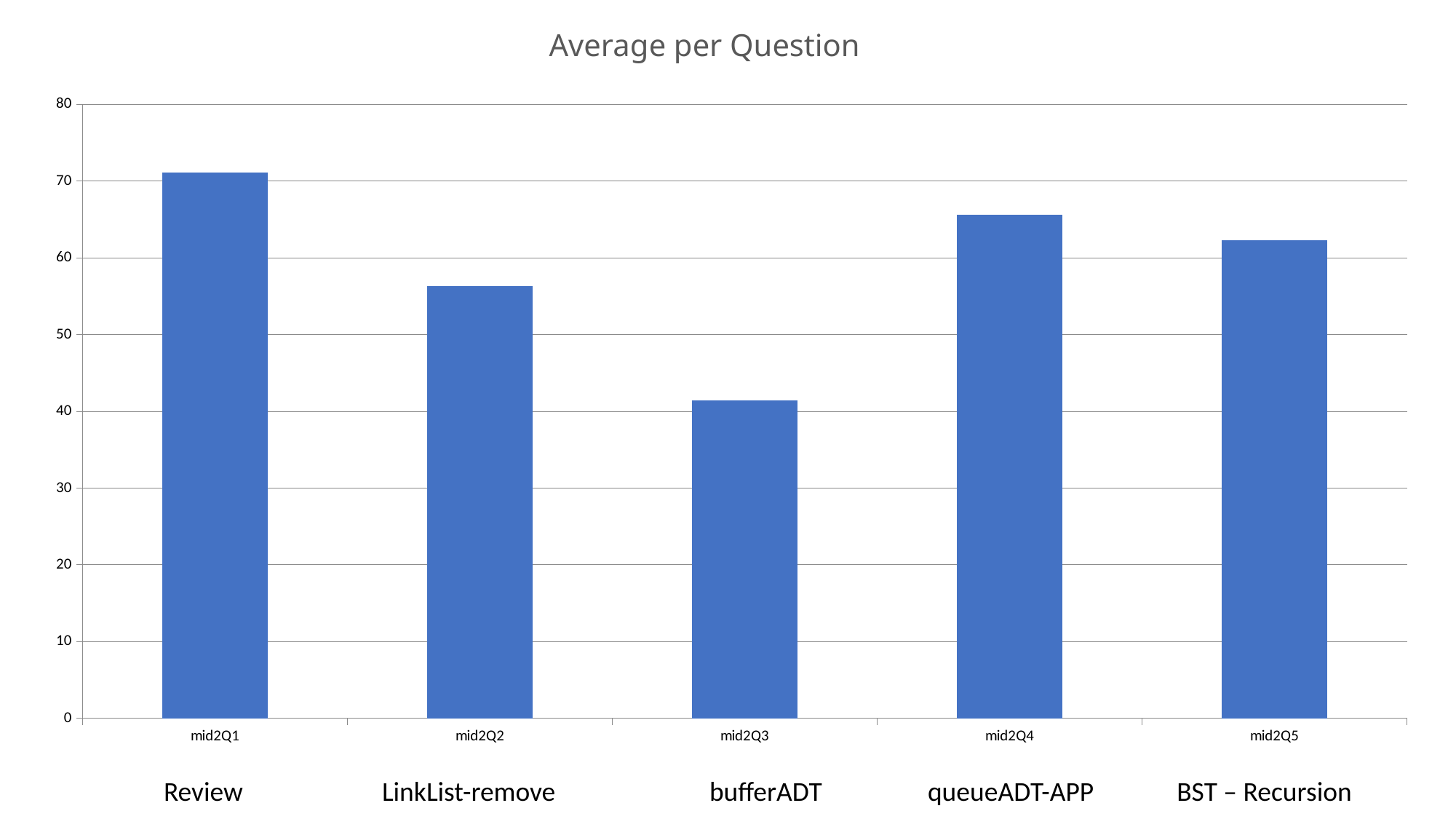
What is the title of the chart? Average per Question How many bars (categories) are plotted in the chart? 5 Which is larger, the value for mid2Q2 or the value for mid2Q4? mid2Q4 What kind of chart is shown on the slide? bar chart Is the value for mid2Q2 greater or less than 60? less Is the value for mid2Q3 greater or less than 50? less Which topic label is shown beneath the mid2Q3 bar? bufferADT Is the value for mid2Q4 greater or less than 60? greater Which category has the lowest value? mid2Q3 Which category has the highest value? mid2Q1